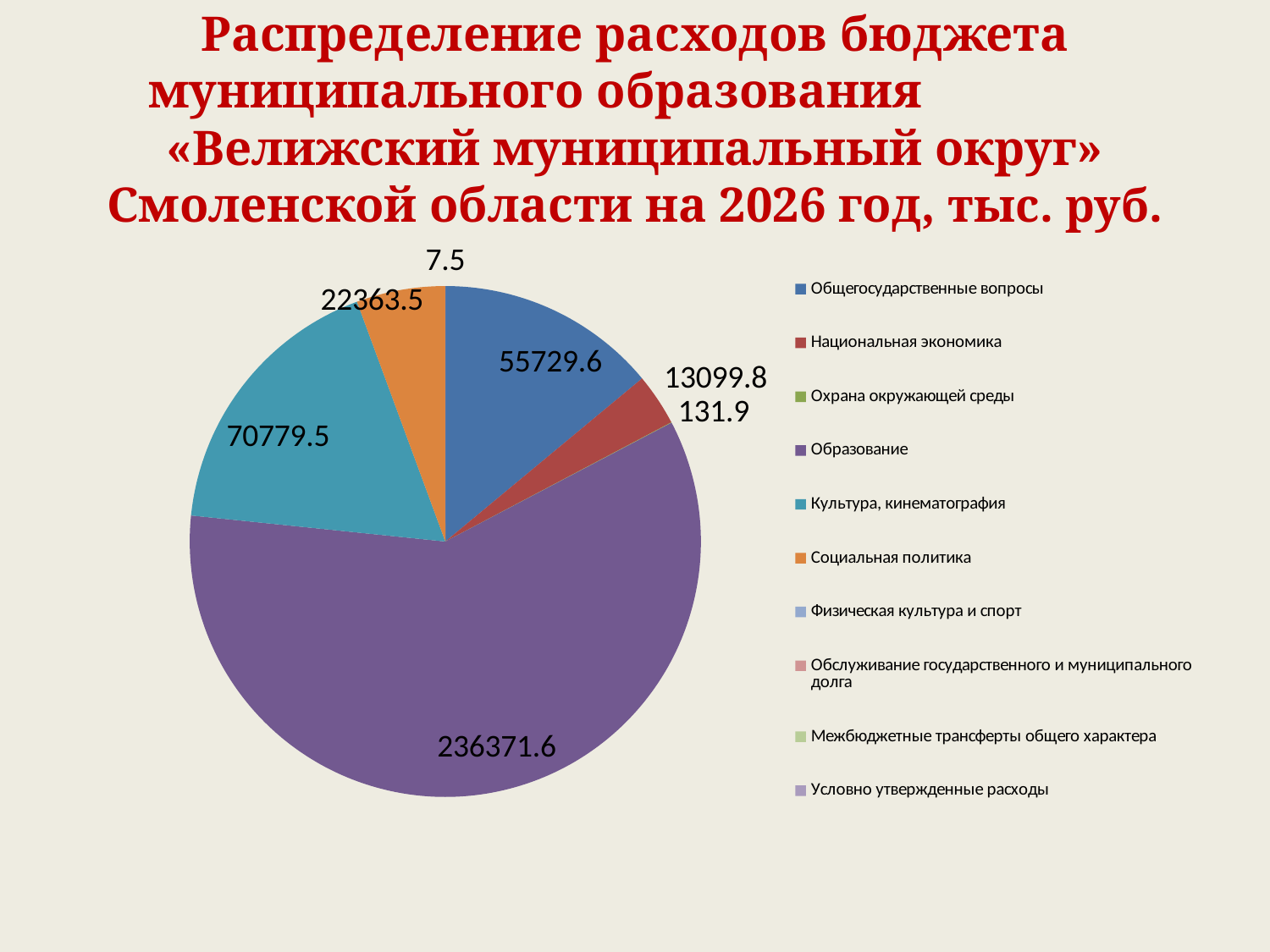
What is the value for Общегосударственные вопросы? 55729.6 What is the difference between the values for Культура, кинематография and Общегосударственные вопросы? 15049.9 Which category has the largest slice of the pie? Образование What is the value for Социальная политика? 22363.5 Which is larger, Культура, кинематография or Общегосударственные вопросы? Культура, кинематография What is the value for Образование? 236371.6 What is the value for Национальная экономика? 13099.8 What colour is the slice for Образование? purple What is the difference between the values for Социальная политика and Национальная экономика? 9263.7 What is the value for Культура, кинематография? 70779.5 How many entries does the legend list? 10 What kind of chart is shown on the slide? pie chart